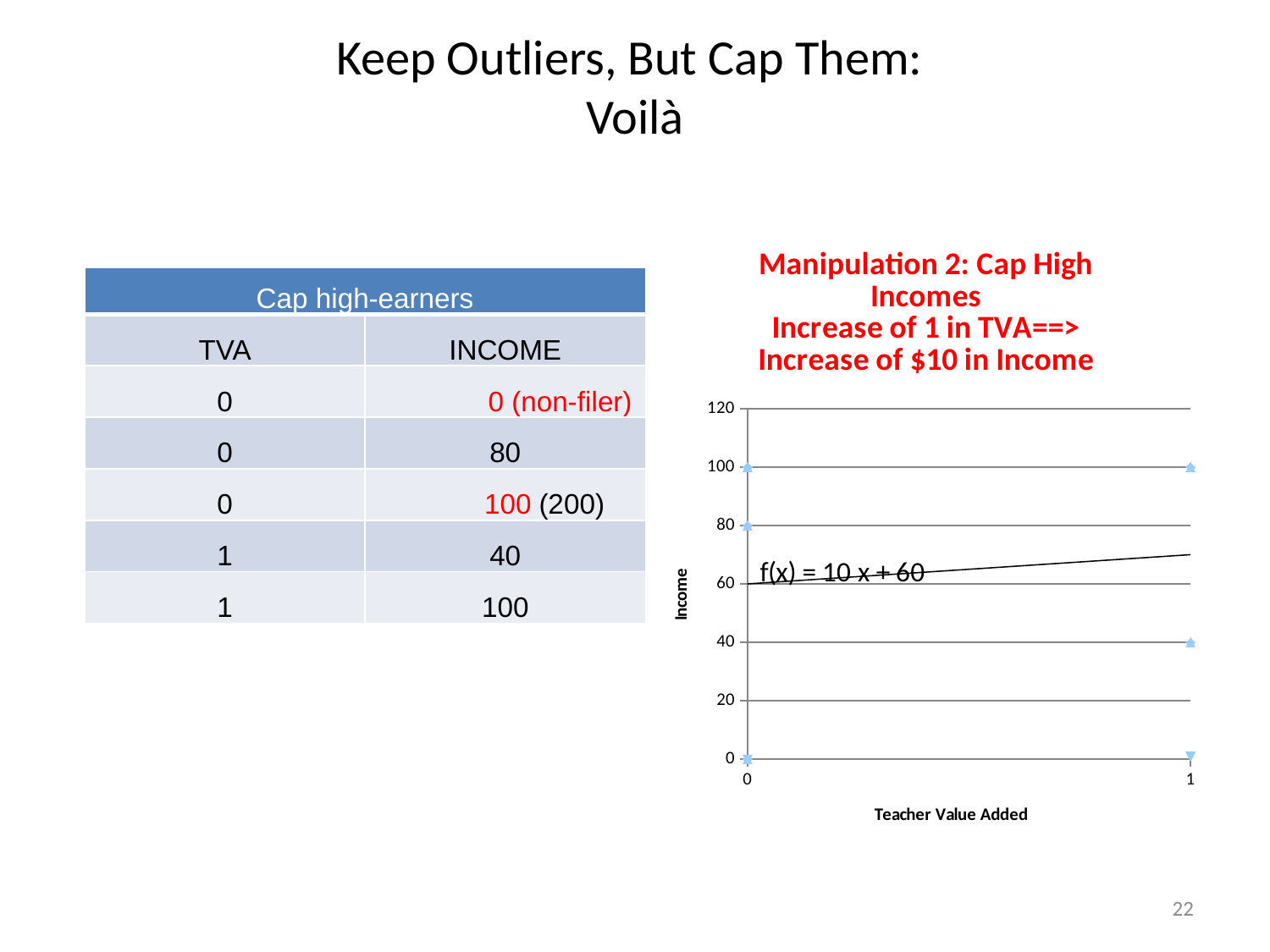
What is the highest Income value plotted on the chart? 100 What is the label of the x axis of the chart? Teacher Value Added Does the trendline rise or fall as Teacher Value Added increases from 0 to 1? rise Is the lowest plotted Income value at Teacher Value Added = 1 greater or less than 60? less What is the lowest Income value plotted on the chart? 0 What is the trendline equation printed on the chart? f(x) = 10 x + 60 What is the label of the y axis of the chart? Income What is the maximum value shown on the Income axis? 120 How many data points are plotted at Teacher Value Added = 0? 3 What kind of chart is shown on the right of the slide? scatter chart